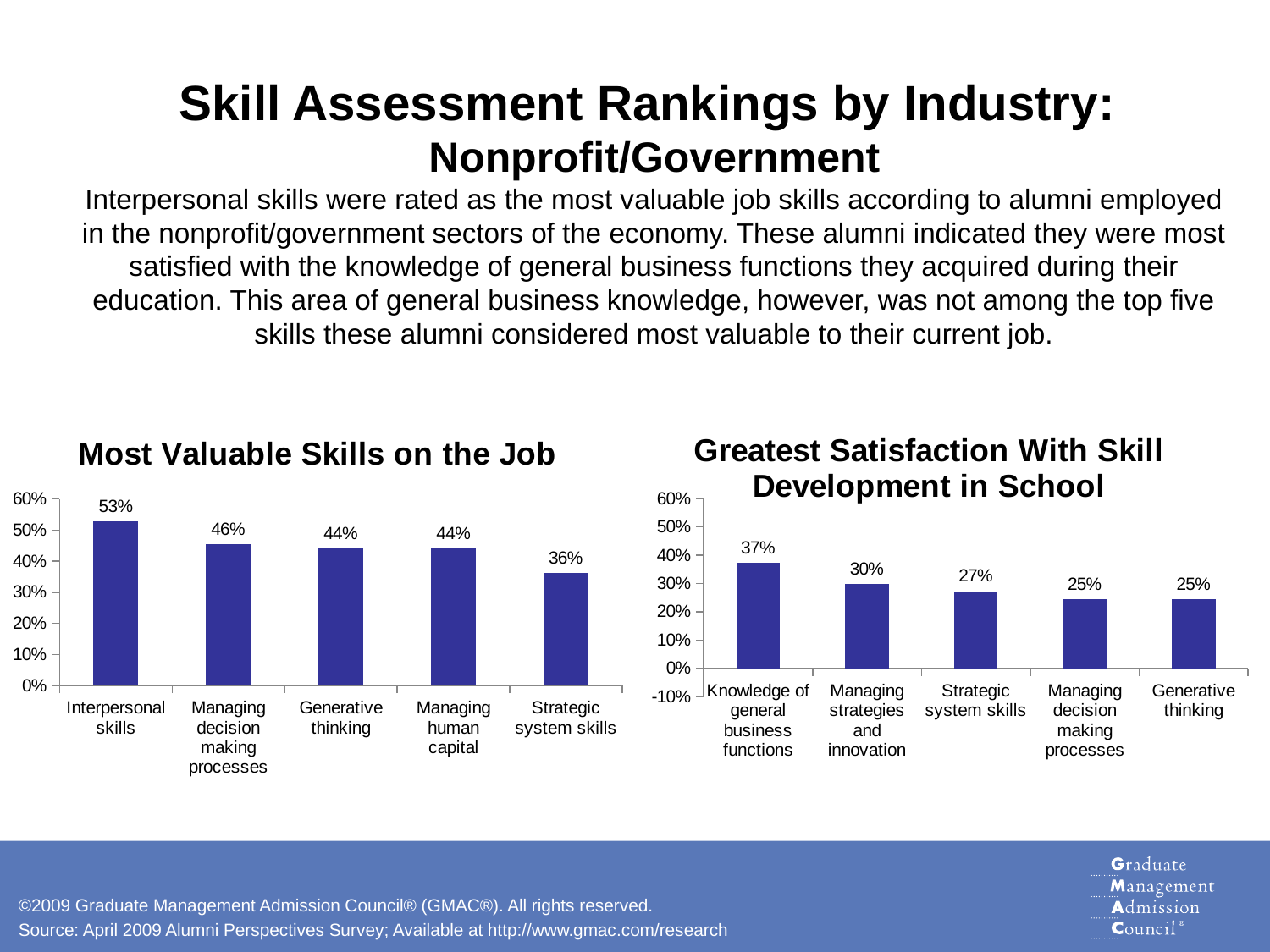
In the 'Greatest Satisfaction With Skill Development in School' chart, which is larger: Managing strategies and innovation or Generative thinking? Managing strategies and innovation In the 'Most Valuable Skills on the Job' chart, what is the value for Interpersonal skills? 53% In the 'Greatest Satisfaction With Skill Development in School' chart, what is the difference between Knowledge of general business functions and Managing strategies and innovation? 7% In the 'Most Valuable Skills on the Job' chart, what is the value for Managing decision making processes? 46% In the 'Greatest Satisfaction With Skill Development in School' chart, which category has the highest value? Knowledge of general business functions In the 'Most Valuable Skills on the Job' chart, how many categories are shown? 5 In the 'Most Valuable Skills on the Job' chart, which category has the lowest value? Strategic system skills What kind of chart is the 'Most Valuable Skills on the Job' chart? Bar chart In the 'Greatest Satisfaction With Skill Development in School' chart, what is the value for Strategic system skills? 27% In the 'Most Valuable Skills on the Job' chart, what is the difference between Interpersonal skills and Strategic system skills? 17% In the 'Greatest Satisfaction With Skill Development in School' chart, do the values rise or fall from left to right? Fall In the 'Greatest Satisfaction With Skill Development in School' chart, what is the value for Knowledge of general business functions? 37%